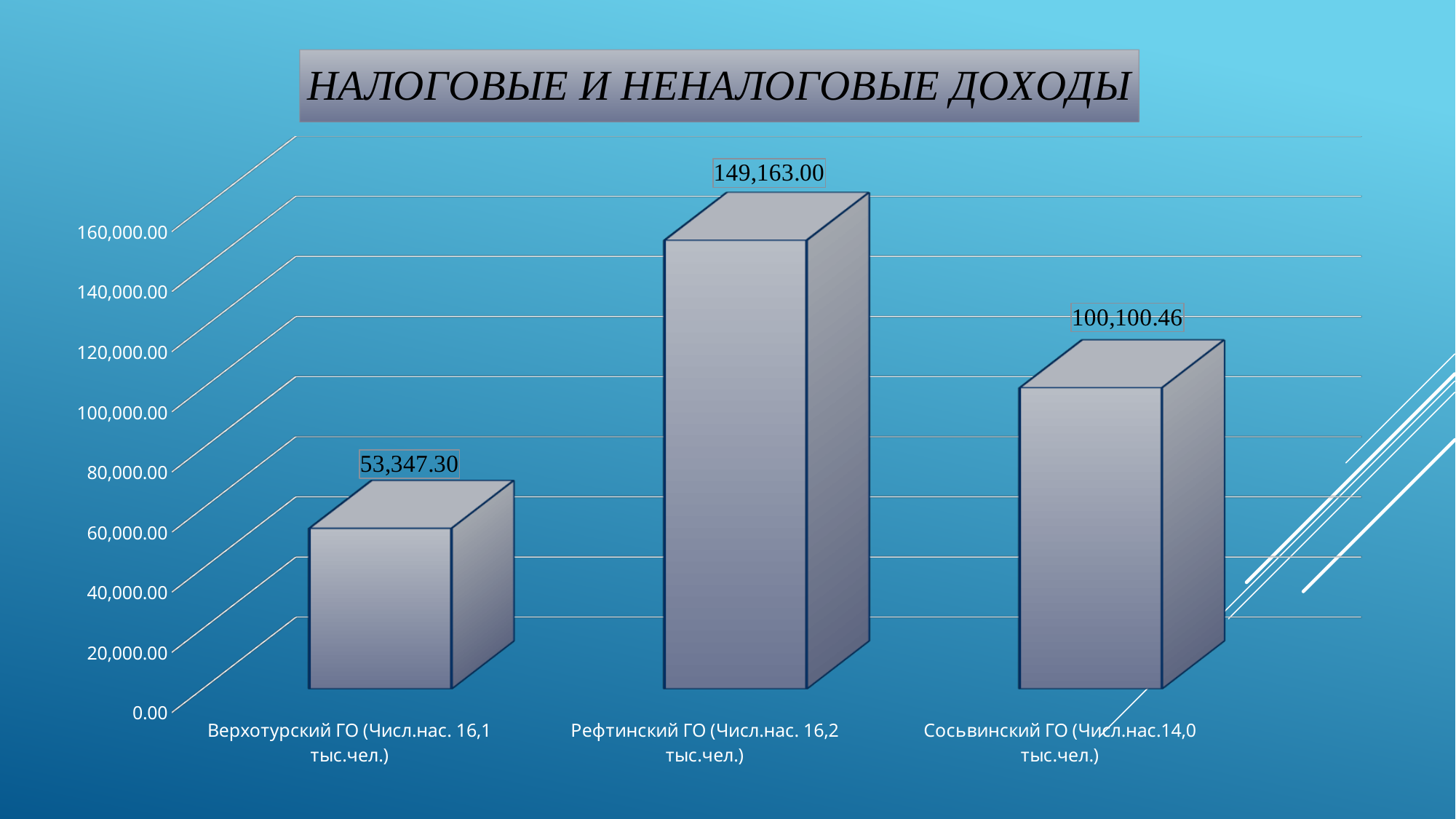
What is the value for Верхотурский ГО? 53,347.30 What kind of chart is shown on the slide? bar chart Which category has the lowest value? Верхотурский ГО How many categories are shown in the chart? 3 What is the title of the chart? НАЛОГОВЫЕ И НЕНАЛОГОВЫЕ ДОХОДЫ What is the value for Сосьвинский ГО? 100,100.46 What is the value for Рефтинский ГО? 149,163.00 Which category has the highest value? Рефтинский ГО Is the value for Верхотурский ГО greater or less than 60,000.00? less What is the difference between the values for Сосьвинский ГО and Верхотурский ГО? 46,753.16 Which is larger, the value for Верхотурский ГО or the value for Сосьвинский ГО? Сосьвинский ГО What is the difference between the values for Рефтинский ГО and Сосьвинский ГО? 49,062.54